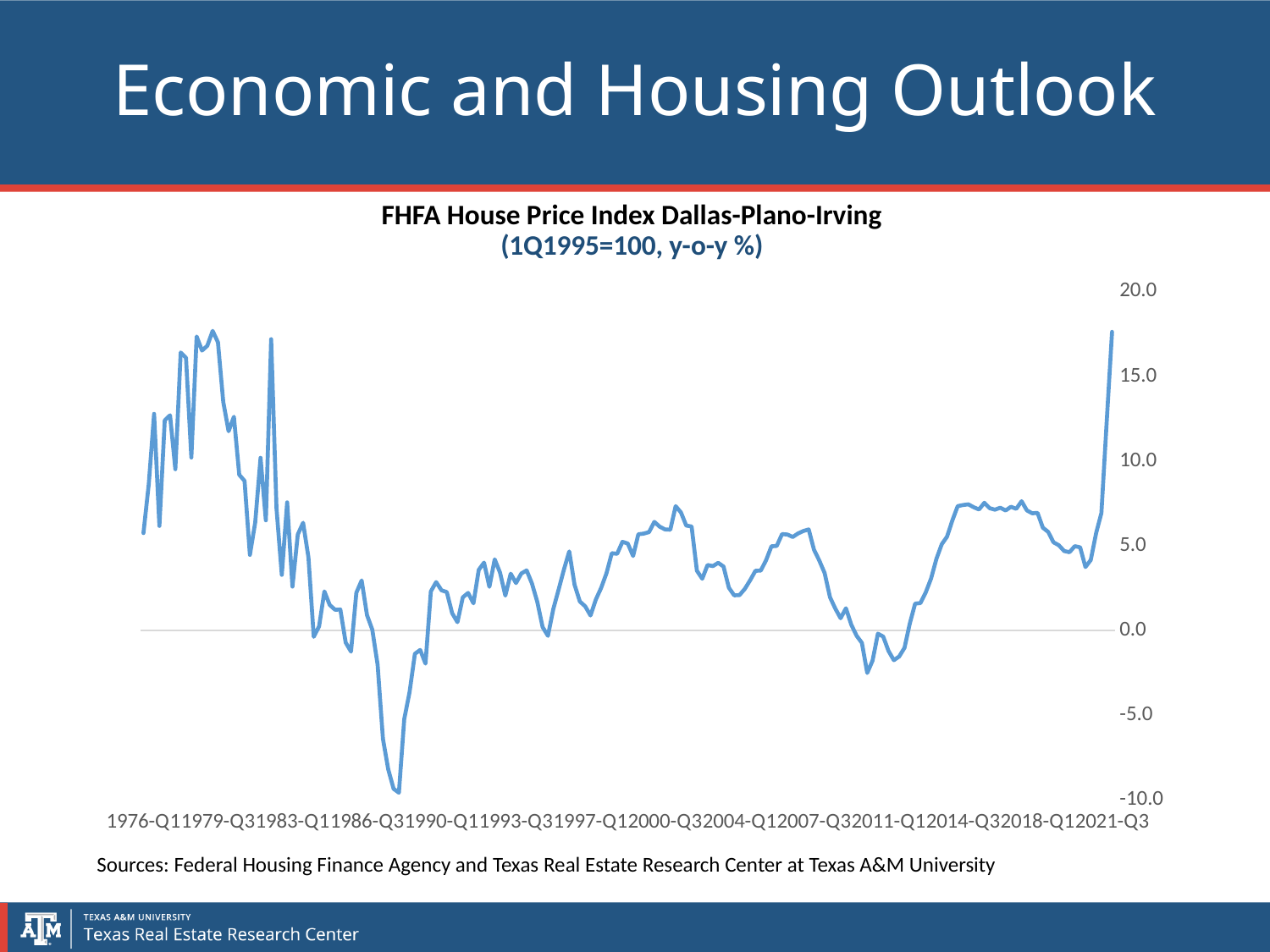
What is the title of the chart? FHFA House Price Index Dallas-Plano-Irving (1Q1995=100, y-o-y %) Is the value at 1990-Q1 greater or less than -5.0? greater Does the line rise or fall between 2018-Q1 and 2021-Q3? rises Is the lowest point on the line greater or less than -5.0? less Is the value at 2021-Q3 greater or less than 15.0? greater What is the highest value shown on the vertical axis of the chart? 20.0 How many date labels are shown along the x axis of the chart? 14 Is the value at 2007-Q3 larger or smaller than the value at 2011-Q1? larger What kind of chart is shown on the slide? line chart